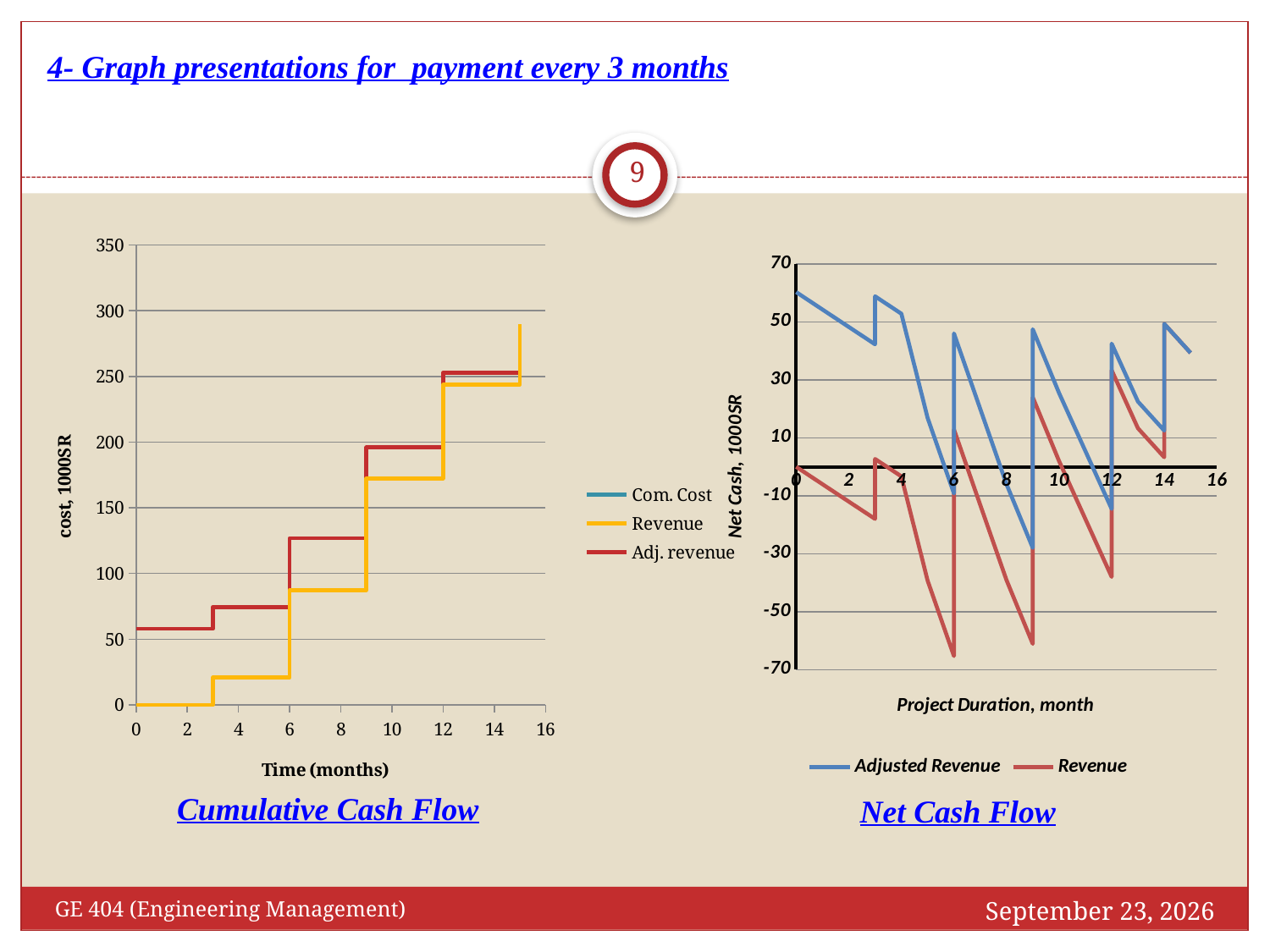
What kind of chart is the Cumulative Cash Flow chart on the left? line chart How many series does the legend of the Cumulative Cash Flow chart list? 3 In the Cumulative Cash Flow chart, is the Revenue value at month 4 greater or less than 50? less In the Net Cash Flow chart, is the Adjusted Revenue value at month 0 greater or less than 50? greater In the Cumulative Cash Flow chart, does the Revenue series rise or fall as time increases from 0 to 15 months? rise How many series does the legend of the Net Cash Flow chart list? 2 In the Net Cash Flow chart, is the lowest Revenue value near month 6 greater or less than -50? less What is the x-axis label of the Net Cash Flow chart? Project Duration, month In the Cumulative Cash Flow chart, which series is higher at month 2: Revenue or Adj. revenue? Adj. revenue What kind of chart is the Net Cash Flow chart on the right? line chart